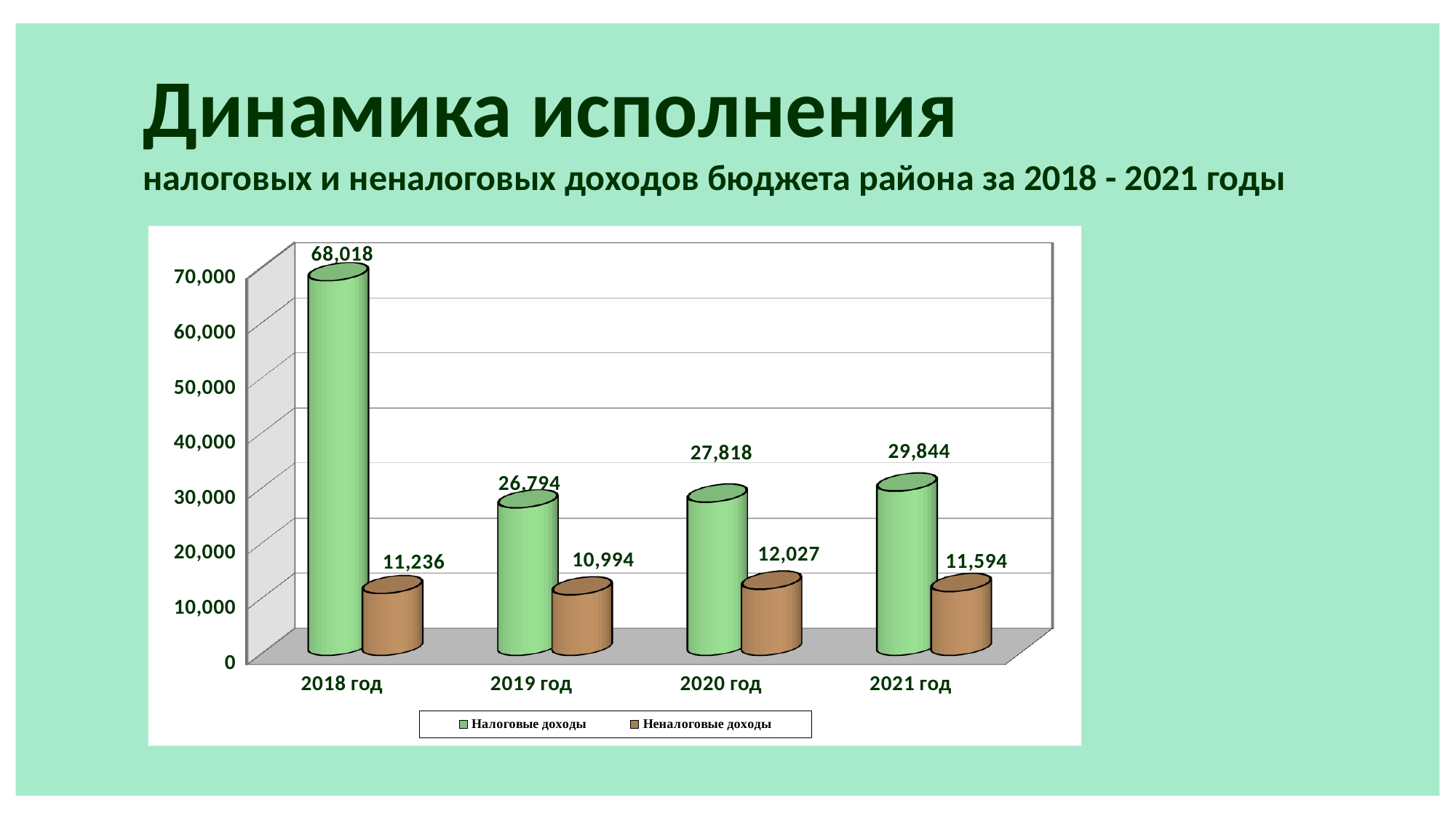
Which is larger: Неналоговые доходы in 2020 год or in 2021 год? 2020 год Which colour represents Неналоговые доходы in the legend? brown In which year is Налоговые доходы highest? 2018 год How many series does the legend list? 2 What kind of chart is shown on the slide? bar chart What is the value of Неналоговые доходы for 2020 год? 12,027 What is the value of Налоговые доходы for 2021 год? 29,844 How many years are shown on the x axis? 4 Is the value of Налоговые доходы for 2020 год greater or less than 30,000? less What is the difference between Налоговые доходы in 2018 год and 2019 год? 41,224 What is the value of Налоговые доходы for 2018 год? 68,018 In which year is Неналоговые доходы lowest? 2019 год